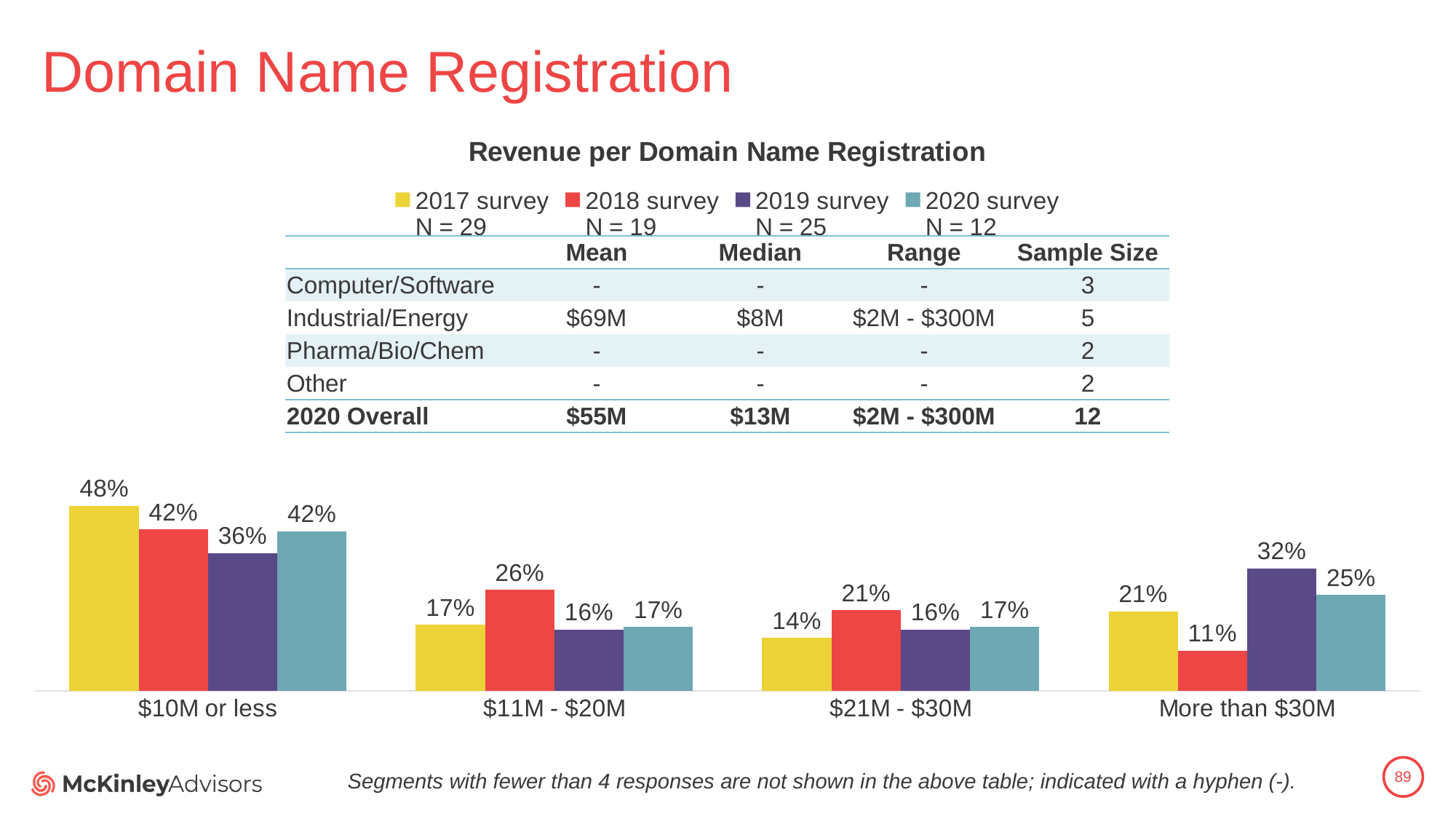
What is the value for the 2017 survey in the "$10M or less" category? 48% How many revenue categories are shown on the x axis of the chart? 4 What is the value for the 2019 survey in the "$21M - $30M" category? 16% What kind of chart is shown on the slide? Bar chart Which survey year has the lowest value in the "$10M or less" category? 2019 survey What is the value for the 2018 survey in the "More than $30M" category? 11% Which is larger in the "$11M - $20M" category: the 2018 survey value or the 2017 survey value? 2018 survey What is the value for the 2020 survey in the "$11M - $20M" category? 17% What is the difference between the 2017 survey and 2019 survey values in the "$10M or less" category? 12% What is the sample size (N) for the 2020 survey shown in the legend? 12 Which survey year has the highest value in the "More than $30M" category? 2019 survey How many series does the chart legend list? 4